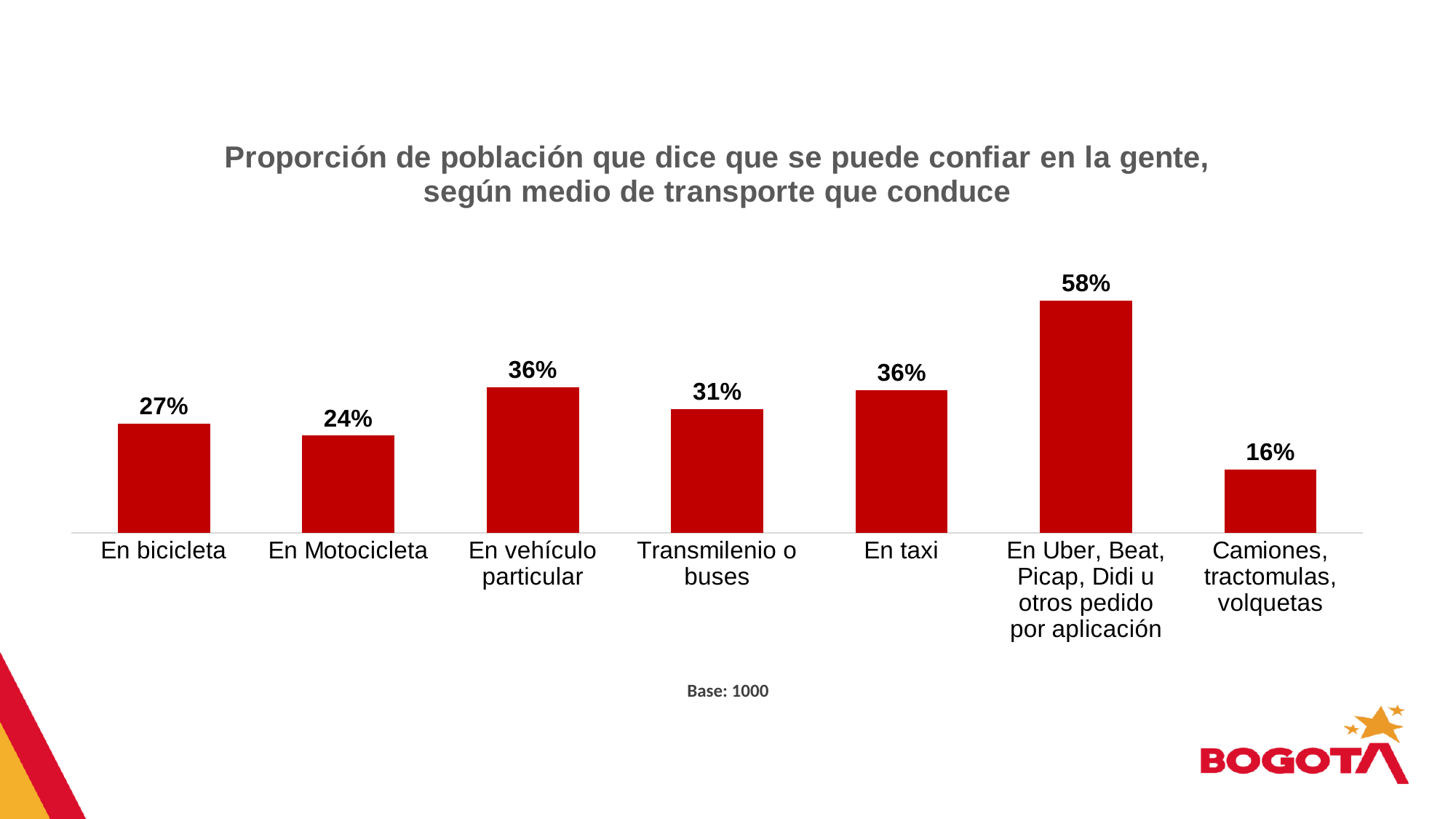
What is the value for Camiones, tractomulas, volquetas? 16% What is the value for Transmilenio o buses? 31% How many categories are shown in the chart? 7 Which category has the highest value? En Uber, Beat, Picap, Didi u otros pedido por aplicación What is the value for En bicicleta? 27% Which is larger, the value for En vehículo particular or the value for Transmilenio o buses? En vehículo particular What is the difference between the value for En Uber, Beat, Picap, Didi u otros pedido por aplicación and the value for En taxi? 22% Which category has the lowest value? Camiones, tractomulas, volquetas What is the base (sample size) noted below the chart? Base: 1000 What is the value for En Motocicleta? 24% What is the difference between the value for En bicicleta and the value for En Motocicleta? 3% What kind of chart is shown on the slide? Bar chart